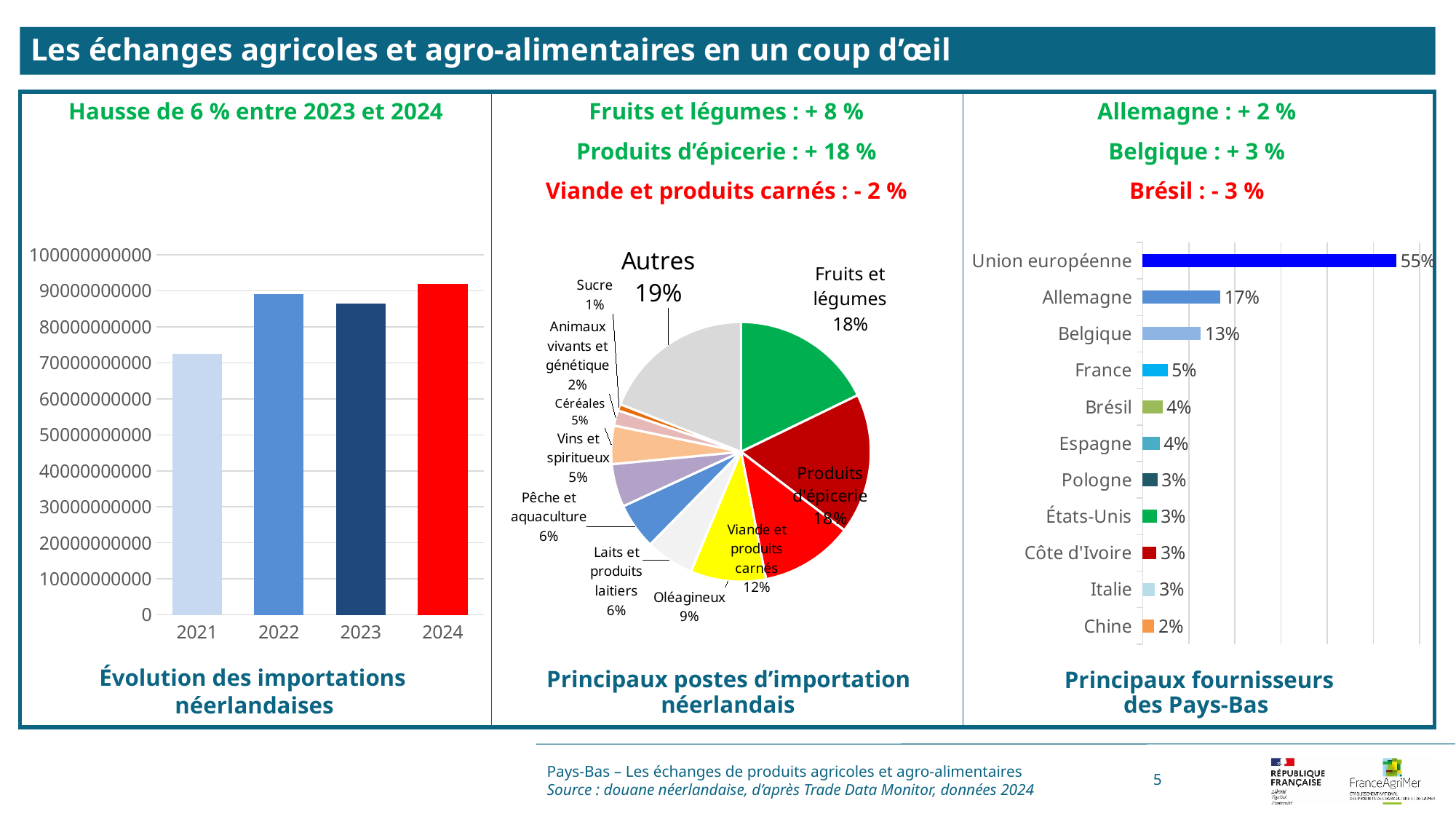
In the pie chart 'Principaux postes d'importation néerlandais', which slice is the smallest? Sucre In the pie chart 'Principaux postes d'importation néerlandais', what share does 'Viande et produits carnés' have? 12% In the chart 'Évolution des importations néerlandaises', is the value for 2024 greater or less than 90000000000? greater In the chart 'Évolution des importations néerlandaises', which year has the highest bar? 2024 How many suppliers are listed in the chart 'Principaux fournisseurs des Pays-Bas'? 11 In the pie chart 'Principaux postes d'importation néerlandais', what is the share of 'Oléagineux'? 9% In the chart 'Évolution des importations néerlandaises', is the value for 2021 greater or less than 80000000000? less In the chart 'Principaux fournisseurs des Pays-Bas', what is the difference between Union européenne and Allemagne? 38% How many years are shown in the chart 'Évolution des importations néerlandaises'? 4 In the chart 'Principaux fournisseurs des Pays-Bas', what is the value for Belgique? 13% In the chart 'Évolution des importations néerlandaises', which year has the lowest bar? 2021 What type of chart is 'Principaux postes d'importation néerlandais'? pie chart